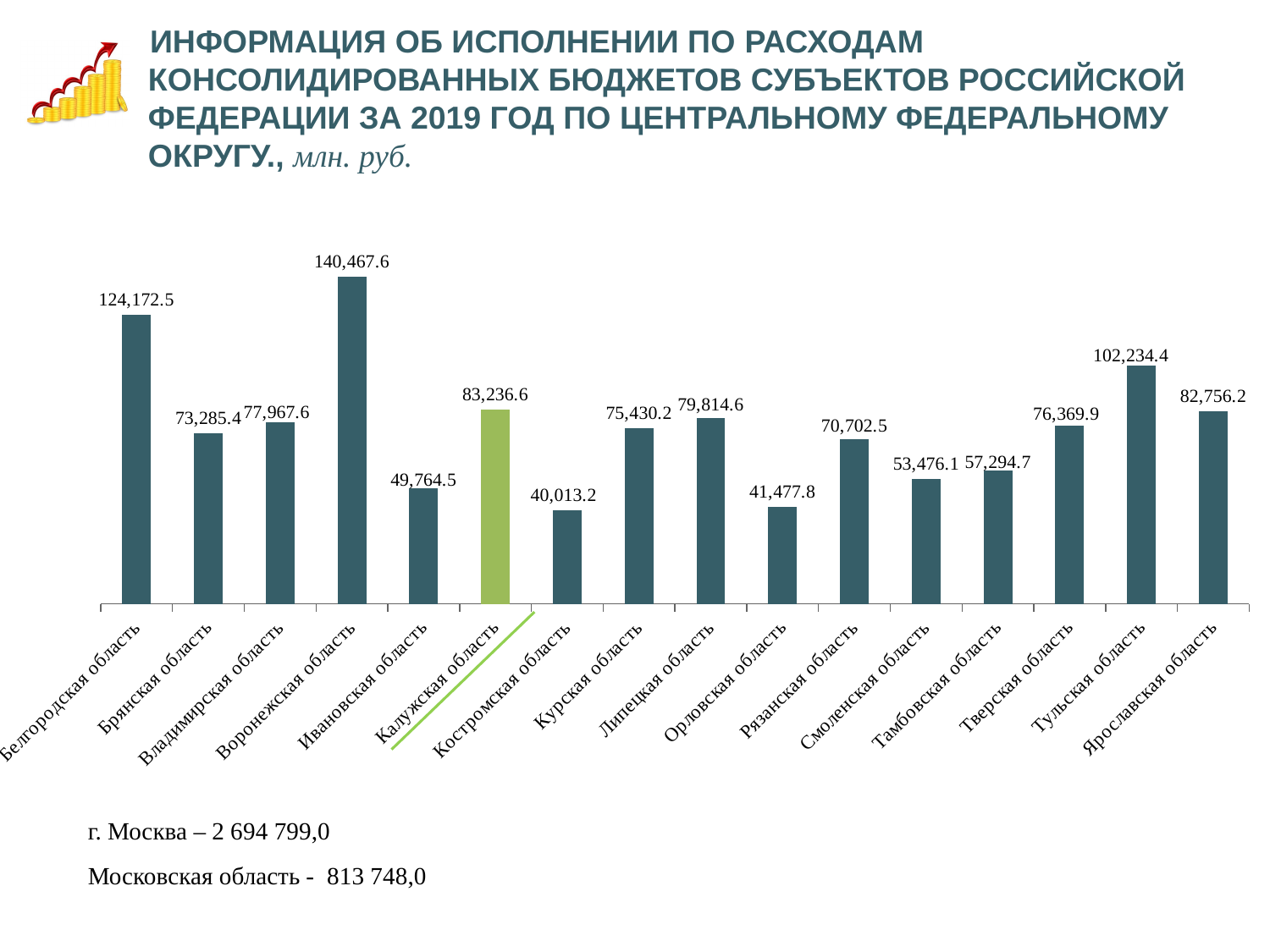
What is the difference between the values for Воронежская область and Белгородская область? 16,295.1 Which region has the highest value? Воронежская область Which is larger, the value for Ивановская область or Орловская область? Ивановская область What is the value for Костромская область? 40,013.2 How many regions are shown in the chart? 16 Which is larger, the value for Тамбовская область or Смоленская область? Тамбовская область What is the value for Калужская область? 83,236.6 What kind of chart is shown on the slide? Bar chart What is the difference between the values for Тульская область and Тверская область? 25,864.5 What is the value for Воронежская область? 140,467.6 What is the value for Тульская область? 102,234.4 Which region has the lowest value? Костромская область